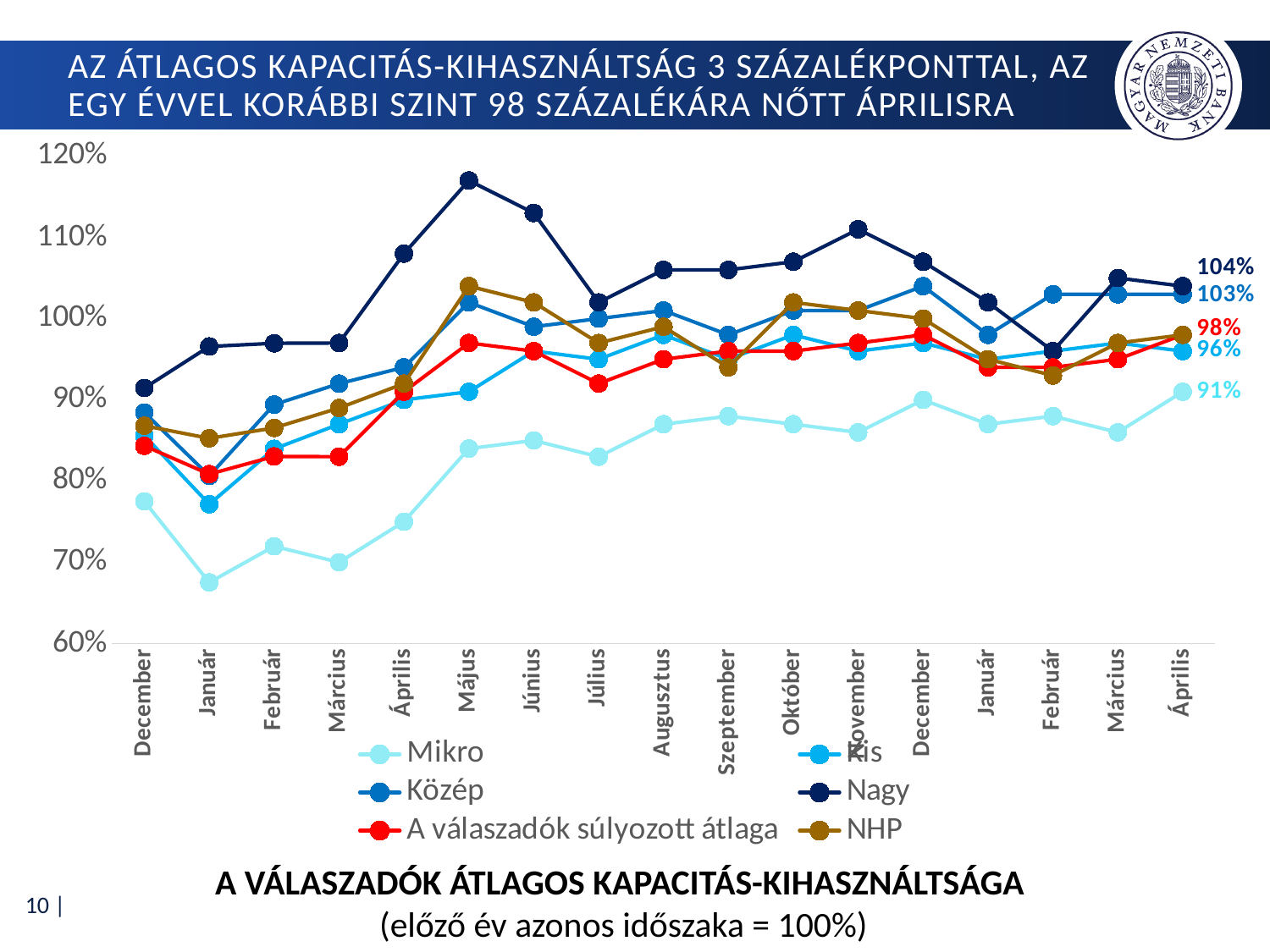
Which series has the lowest value in the first Január? Mikro What is the value for Nagy in the final Április? 104% How many series does the legend list? 6 What is the difference between the Nagy and Mikro values in the final Április? 13 percentage points Is the value for Mikro in the first Január greater or less than 70%? less What is the value for Közép in the final Április? 103% What kind of chart is shown on the slide? Line chart Is the value for Nagy in Május greater or less than 110%? greater Which series has the highest value in Május? Nagy What is the value for Mikro in the final Április? 91% In the final Április, which is larger: the value for Közép or the value for Kis? Közép What is the value for Kis in the final Április? 96%